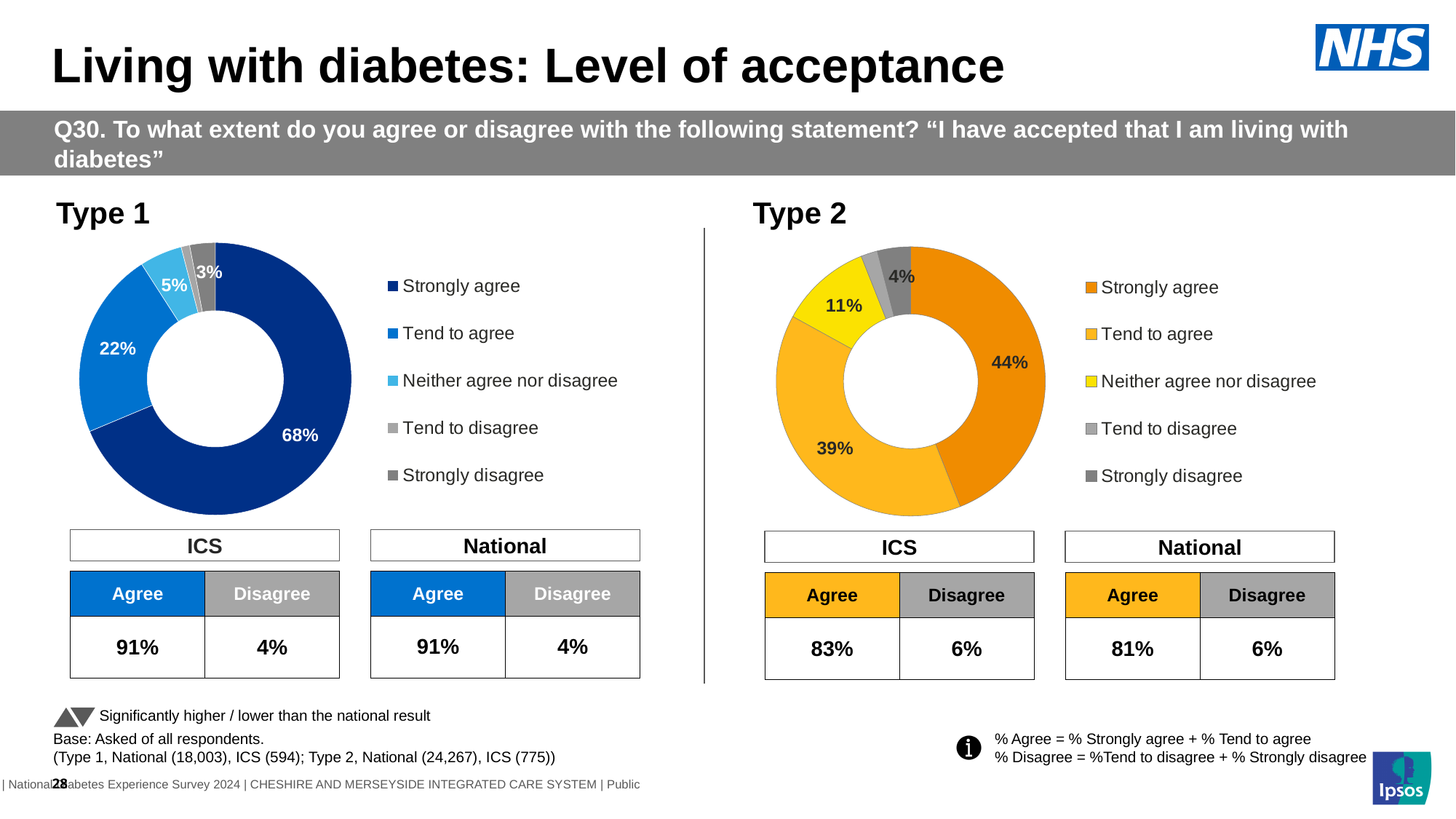
How many response categories does the legend of the Type 1 chart list? 5 In the Type 2 chart, what percentage neither agree nor disagree? 11% In the Type 1 chart, what is the difference in percentage points between Strongly agree and Tend to agree? 46 percentage points What kind of chart is used for the Type 2 data? Doughnut (pie) chart Which chart shows a larger share for Tend to agree, Type 1 or Type 2? Type 2 In the Type 1 chart, what percentage of respondents tend to agree? 22% In the Type 2 chart, what percentage of respondents strongly agree? 44% In the Type 1 chart, what percentage of respondents strongly agree? 68% In the Type 2 chart, what percentage of respondents tend to agree? 39% In the Type 1 chart, which response category has the largest share? Strongly agree In the Type 2 chart, which response category has the largest share? Strongly agree In the Type 1 chart, what percentage neither agree nor disagree? 5%